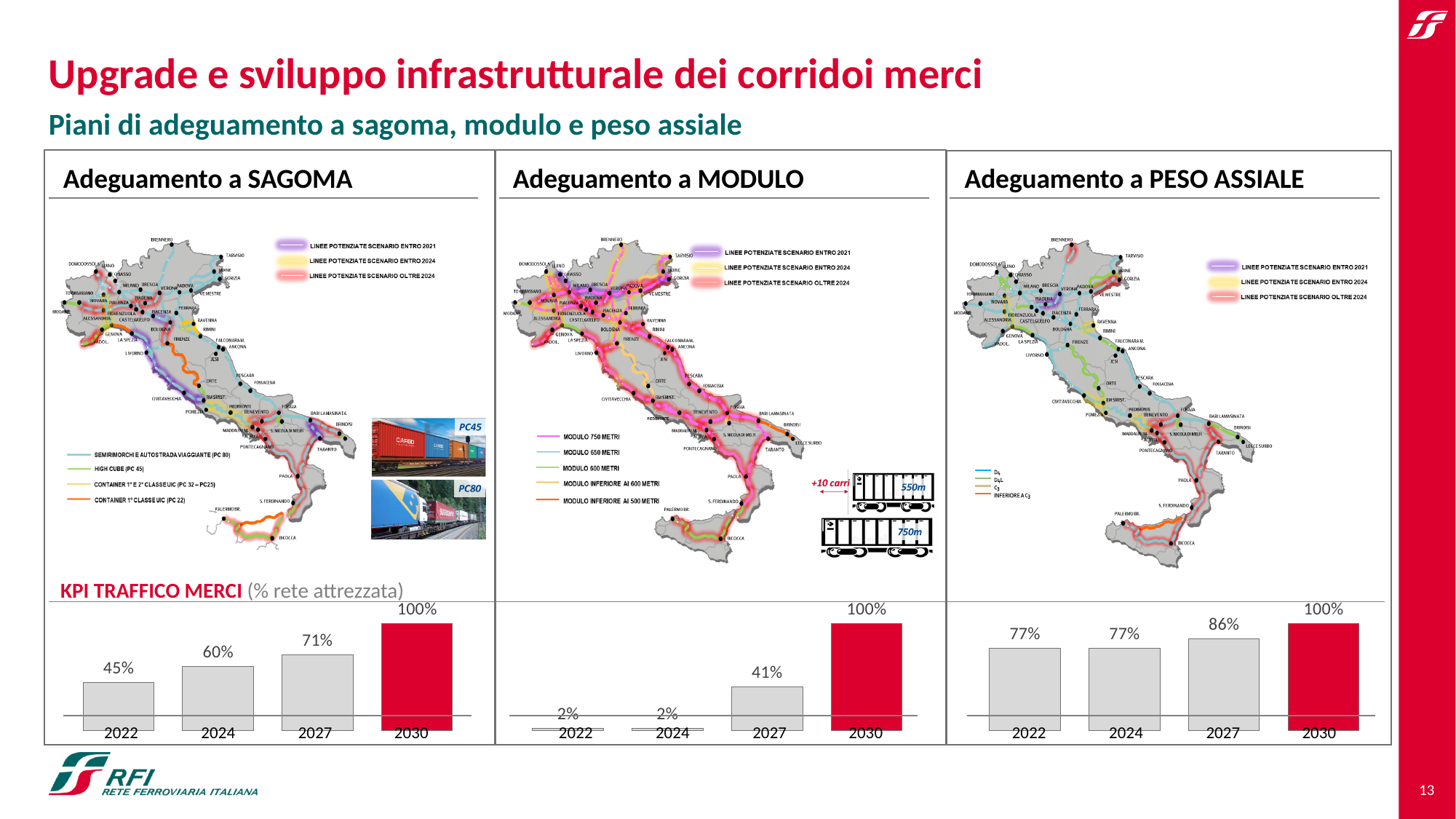
In the Adeguamento a MODULO chart, do the values rise or fall from 2022 to 2030? rise In the Adeguamento a SAGOMA chart, which year has the lowest value? 2022 In the Adeguamento a PESO ASSIALE chart, which year has the highest value? 2030 What kind of chart is used for the KPI TRAFFICO MERCI data under Adeguamento a SAGOMA? bar chart In the Adeguamento a SAGOMA chart, what is the difference between the 2027 and 2022 values? 26% In the Adeguamento a MODULO chart, what is the difference between the 2030 and 2027 values? 59% In the Adeguamento a PESO ASSIALE chart, is the value for 2027 larger or smaller than the value for 2024? larger In the Adeguamento a PESO ASSIALE chart, which bar is coloured red? 2030 In the Adeguamento a MODULO chart, what is the value for 2027? 41% How many years are shown on the x axis of the Adeguamento a MODULO chart? 4 In the Adeguamento a SAGOMA chart, what is the value for 2024? 60% In the Adeguamento a PESO ASSIALE chart, what is the value for 2022? 77%